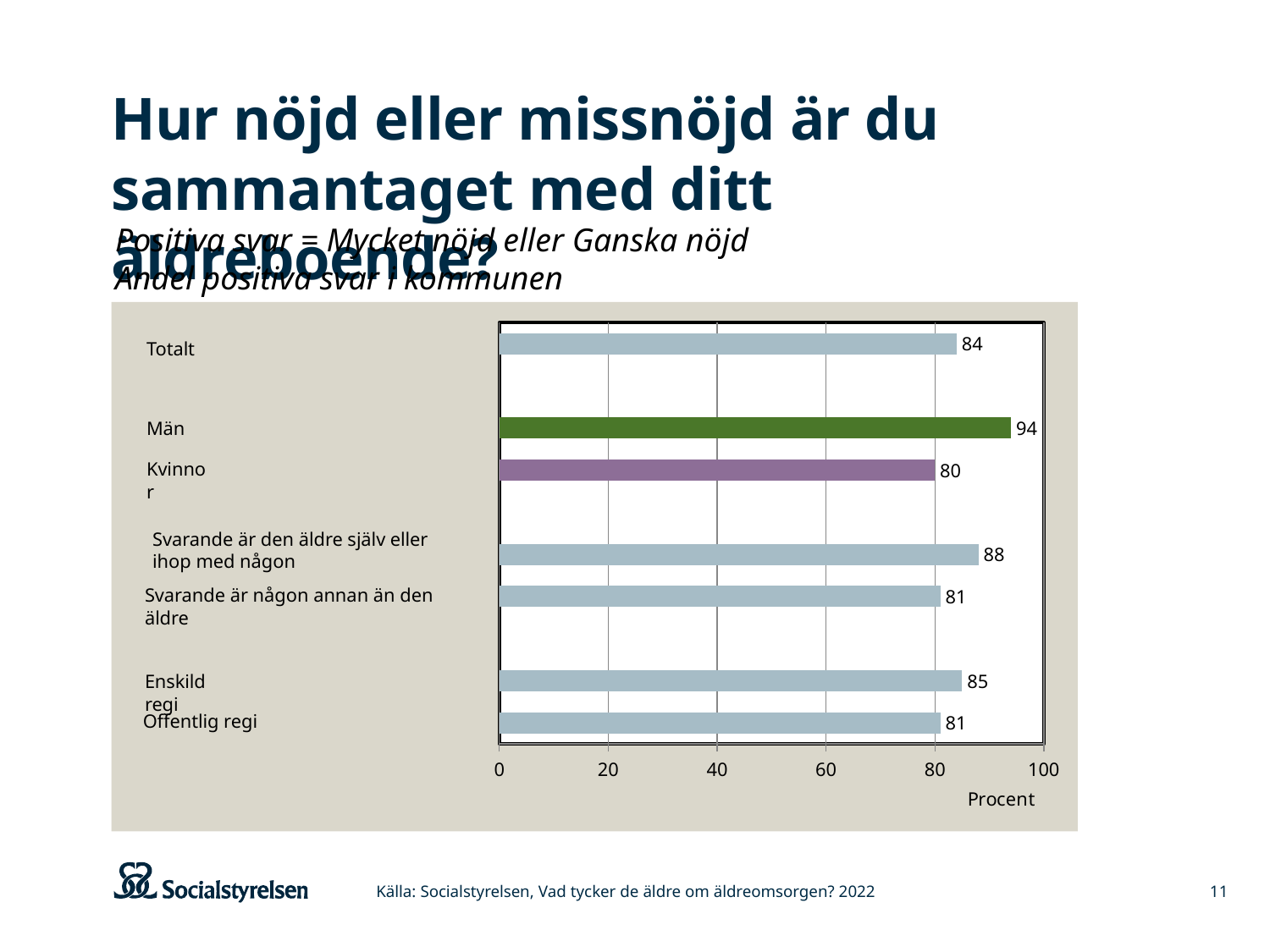
How many categories are shown in the chart? 7 What is the label of the horizontal axis? Procent What is the value for Totalt? 84 Which is larger, the value for Enskild regi or the value for Offentlig regi? Enskild regi What is the value for Enskild regi? 85 What is the value for Kvinnor? 80 What is the difference between the values for Män and Kvinnor? 14 Which category has the lowest value? Kvinnor Which category has the highest value? Män What is the value for Män? 94 What is the value for Offentlig regi? 81 What kind of chart is shown on the slide? Bar chart